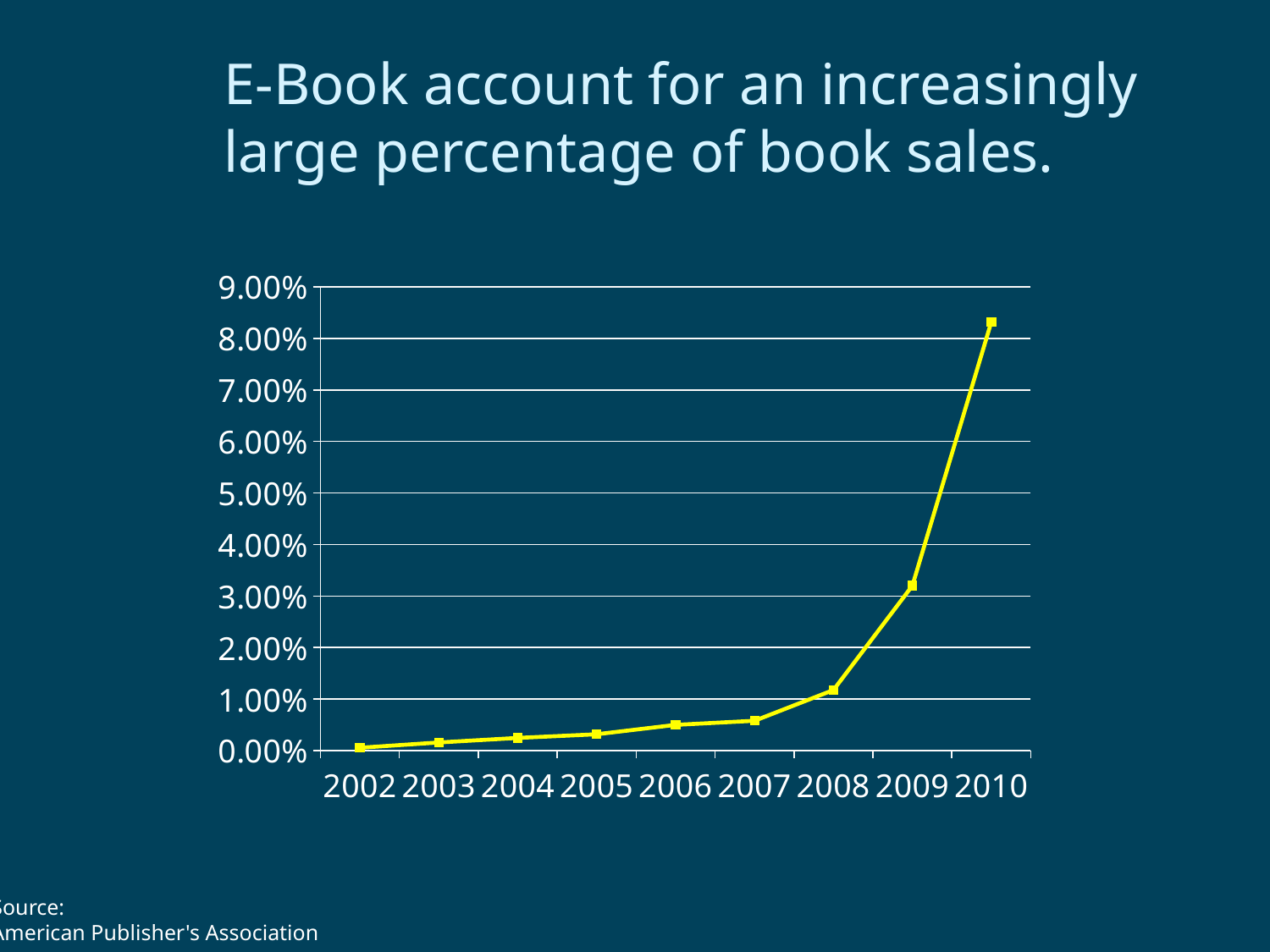
How many years are plotted on the x axis? 9 Do the values rise or fall from 2002 to 2010? rise Is the value for 2007 greater or less than 1.00%? less Which year has the highest value? 2010 Is the value for 2008 greater or less than 2.00%? less What colour is the plotted line? yellow Is the value for 2010 greater or less than 8.00%? greater What is the title of the slide? E-Book account for an increasingly large percentage of book sales. Which is larger, the value for 2009 or the value for 2008? 2009 Which year has the lowest value? 2002 What kind of chart is shown on the slide? line chart